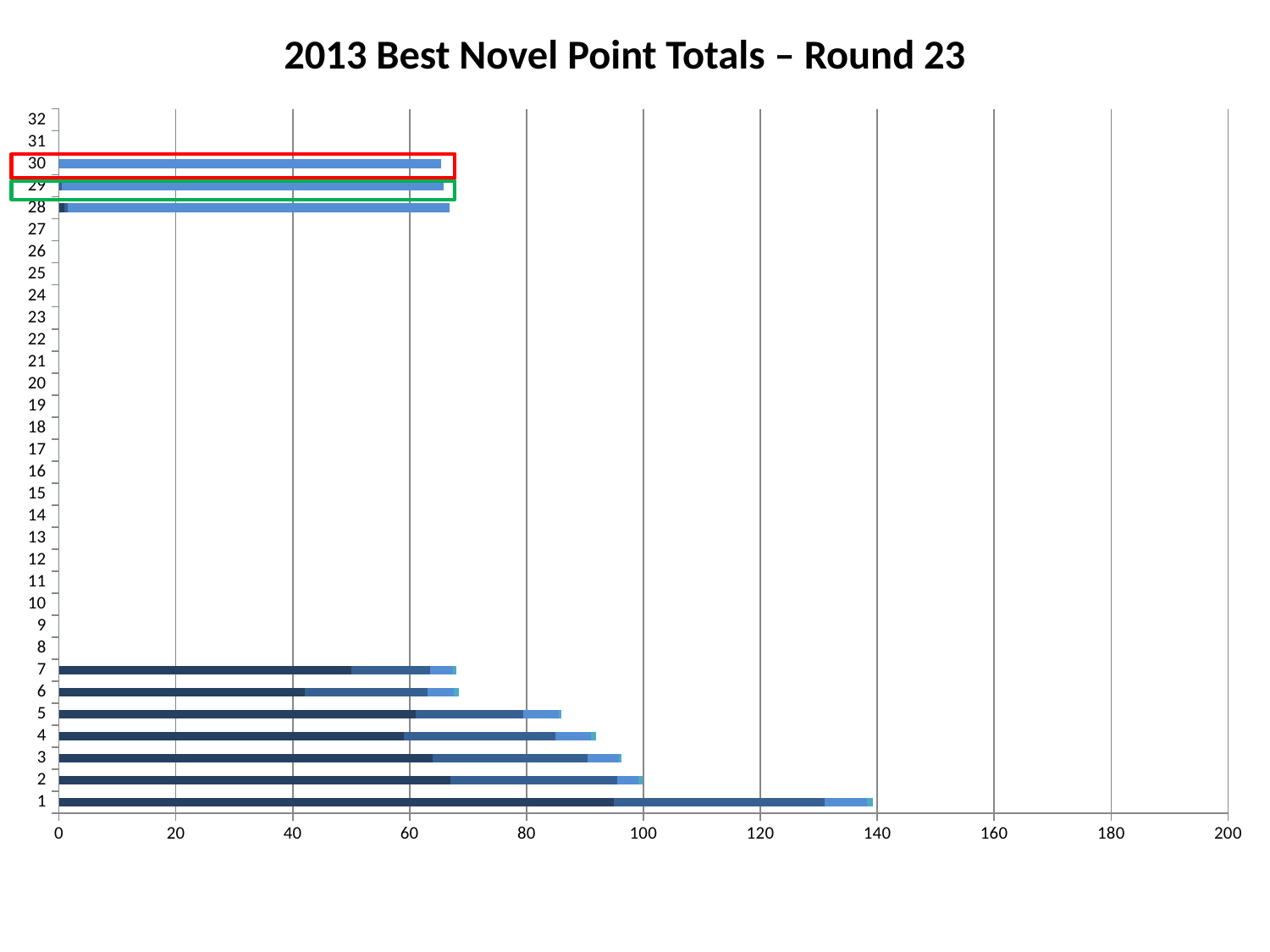
Which has the larger total, category 3 or category 5? category 3 Which has the larger total, category 1 or category 2? category 1 Which category has the longest bar? 1 Is the total value for category 1 greater or less than 120? greater Is the total value for category 5 greater or less than 80? greater Is the total value for category 3 greater or less than 100? less What kind of chart is shown on the slide? bar chart What is the title of the chart? 2013 Best Novel Point Totals – Round 23 How many categories are labelled on the vertical axis? 32 Do the bar totals rise or fall as the category number goes from 1 to 7? fall